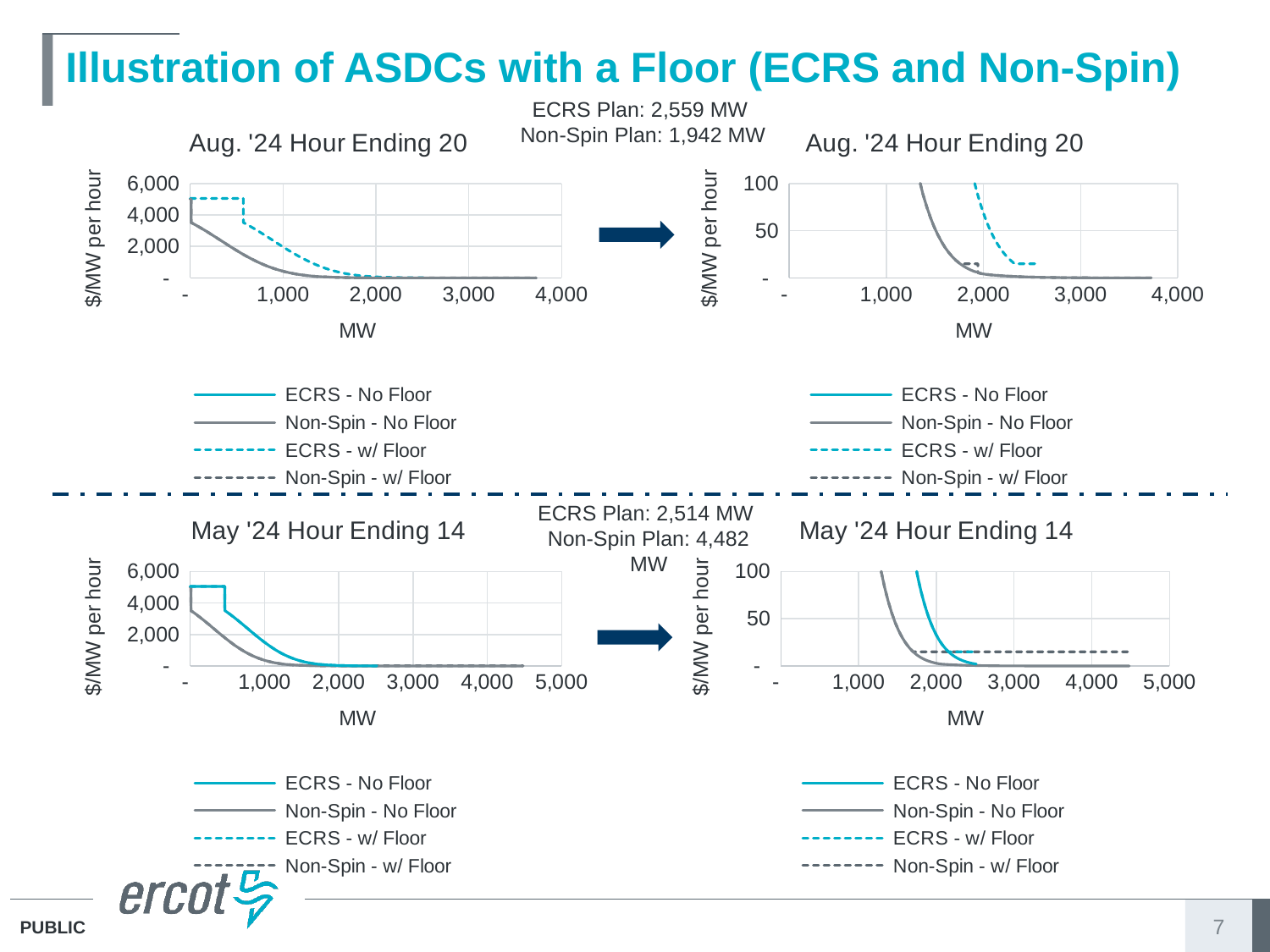
What is the x-axis title of the top-right "Aug. '24 Hour Ending 20" chart? MW How many series does the legend of the top-left "Aug. '24 Hour Ending 20" chart list? 4 In the top-left "Aug. '24 Hour Ending 20" chart, is the value of the Non-Spin - No Floor series at 0 MW greater or less than 2,000? greater How many series does the legend of the bottom-right "May '24 Hour Ending 14" chart list? 4 What type of chart is the top-left chart titled "Aug. '24 Hour Ending 20"? Line chart In the bottom-left "May '24 Hour Ending 14" chart, is the value of the ECRS - No Floor series at 0 MW greater or less than 4,000? greater In the bottom-left "May '24 Hour Ending 14" chart, do the plotted values rise or fall as MW increases along the x axis? Fall What is the y-axis title of the bottom-left "May '24 Hour Ending 14" chart? $/MW per hour In the top-left "Aug. '24 Hour Ending 20" chart, is the value of the ECRS - w/ Floor series at 0 MW greater or less than 4,000? greater In the top-left "Aug. '24 Hour Ending 20" chart, do the plotted values rise or fall as MW increases along the x axis? Fall